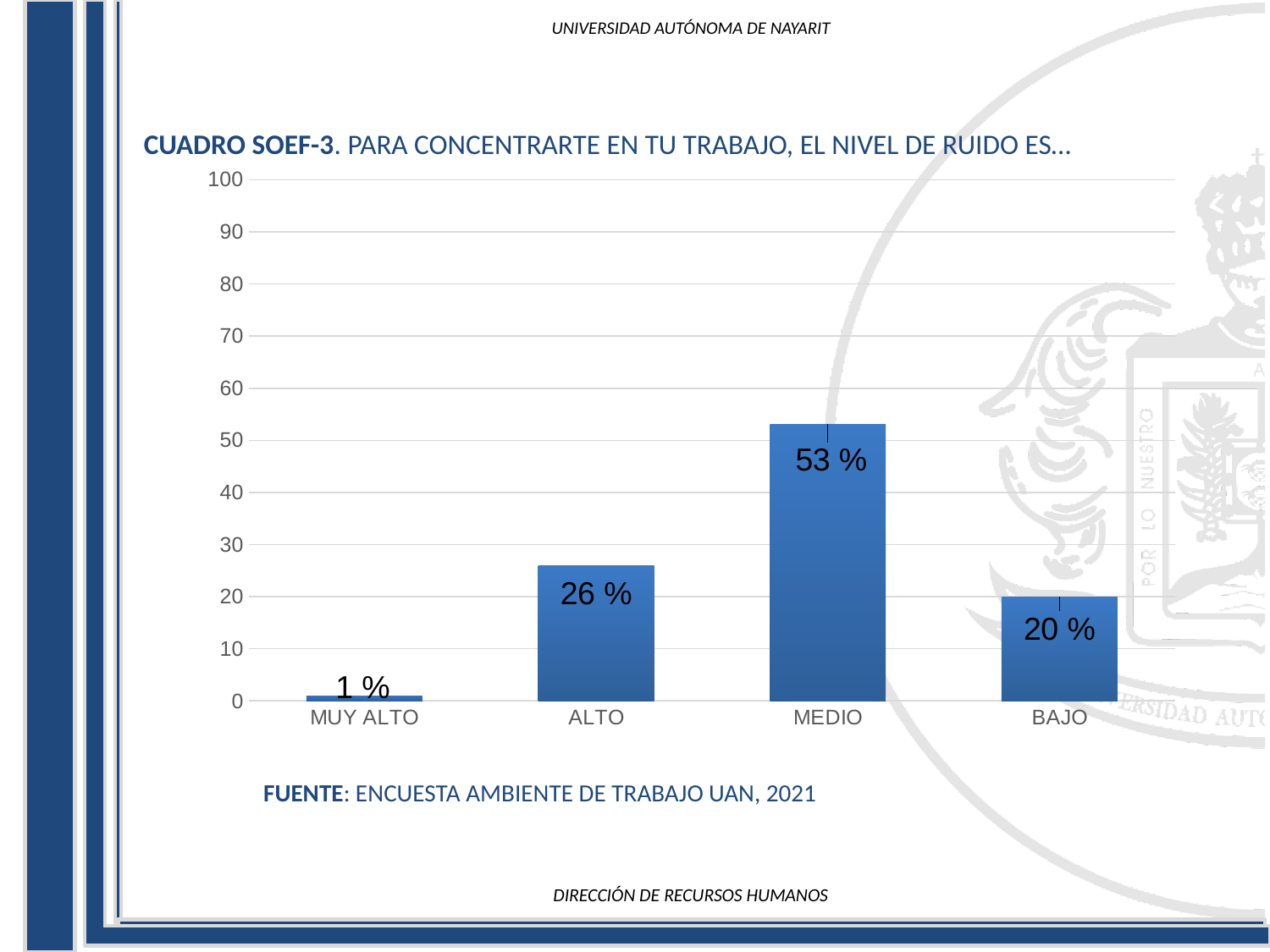
What is the value for BAJO? 20 % What is the value for ALTO? 26 % How many categories are shown on the x axis? 4 Which category has the lowest value? MUY ALTO What kind of chart is shown on the slide? bar chart Which is larger, the value for ALTO or the value for BAJO? ALTO What is the difference between the values for MEDIO and ALTO? 27 % What is the value for MEDIO? 53 % What is the value for MUY ALTO? 1 % Which category has the highest value? MEDIO What is the source cited below the chart? ENCUESTA AMBIENTE DE TRABAJO UAN, 2021 Is the value for MEDIO greater or less than 50? greater